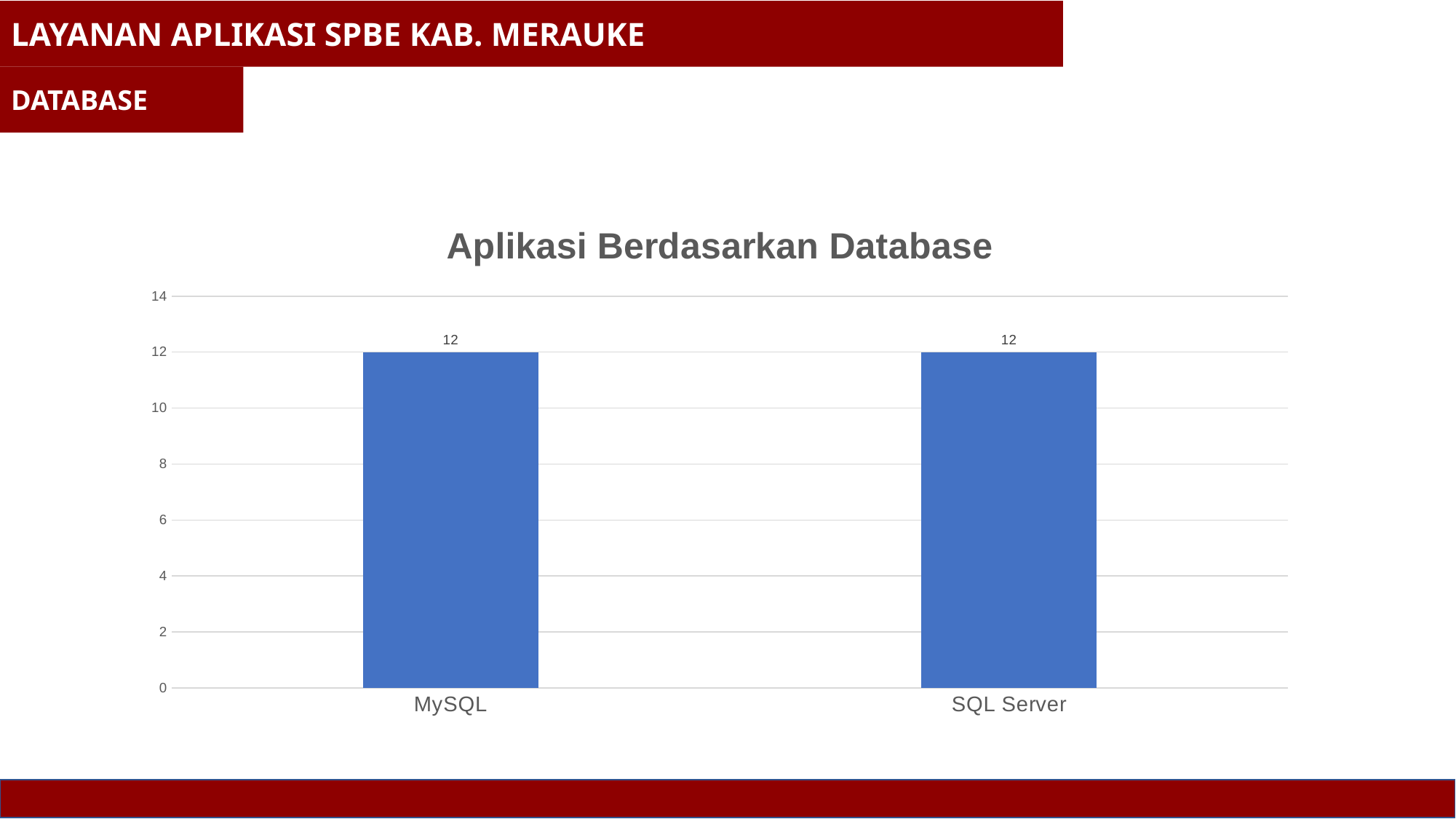
Do MySQL and SQL Server have the same value? Yes What is the value for MySQL? 12 What kind of chart is shown on the slide? bar chart Is the value for SQL Server greater or less than 14? less What is the difference between the values for MySQL and SQL Server? 0 How many categories are shown on the x axis? 2 What is the title of the chart? Aplikasi Berdasarkan Database What is the value for SQL Server? 12 Is the value for MySQL greater or less than 10? greater What is the highest value shown on the y axis? 14